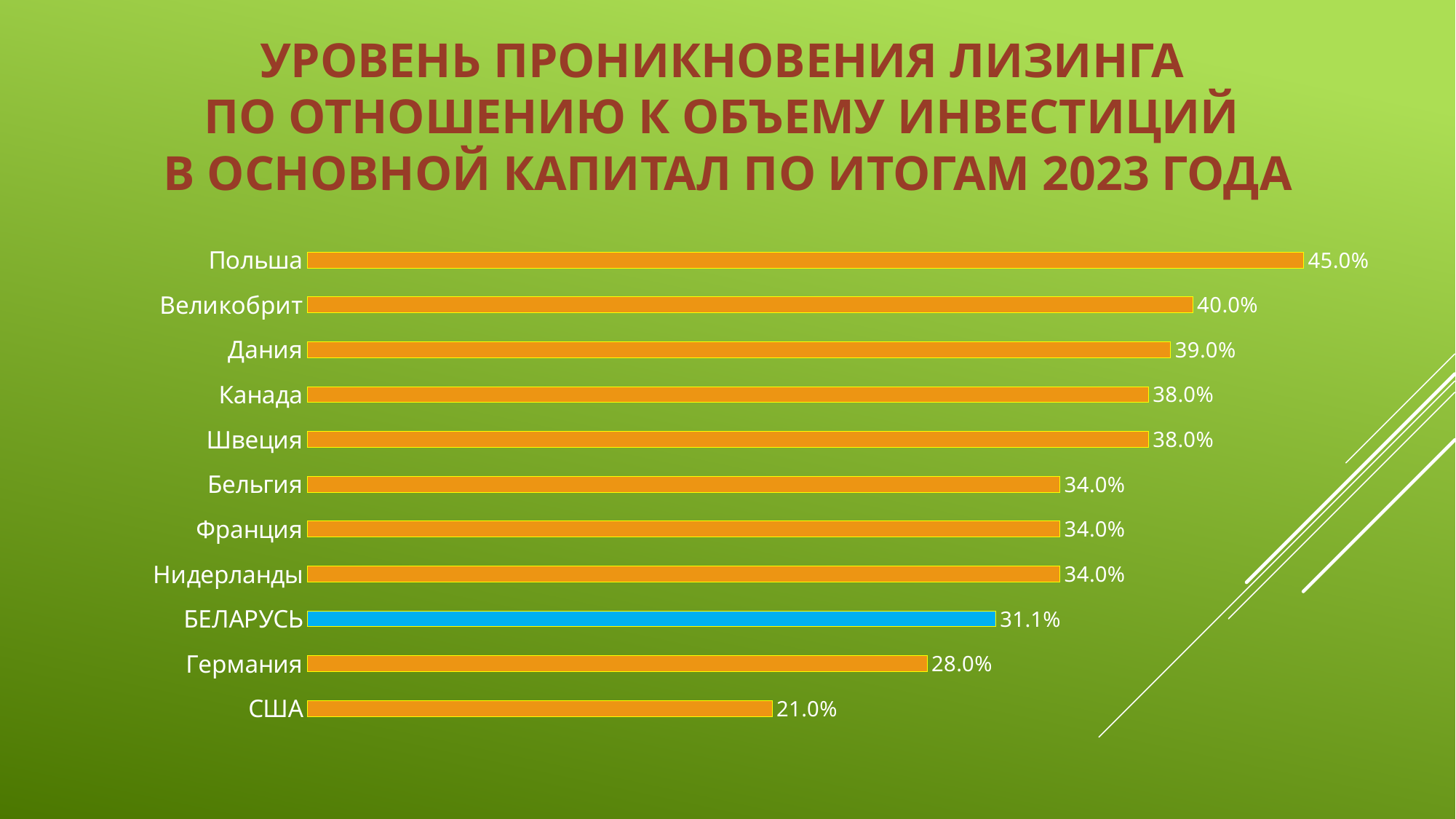
Which is larger, the value for Дания or the value for Германия? Дания What is the value for Германия? 28.0% Which category has the lowest value? США Which category's bar is coloured blue instead of orange? БЕЛАРУСЬ How many categories are shown in the chart? 11 What is the value for БЕЛАРУСЬ? 31.1% What kind of chart is shown on the slide? Bar chart What is the value for Канада? 38.0% What is the value for Польша? 45.0% Which category has the highest value? Польша What is the difference between the values for Польша and США? 24.0% What is the difference between the values for Великобрит and БЕЛАРУСЬ? 8.9%